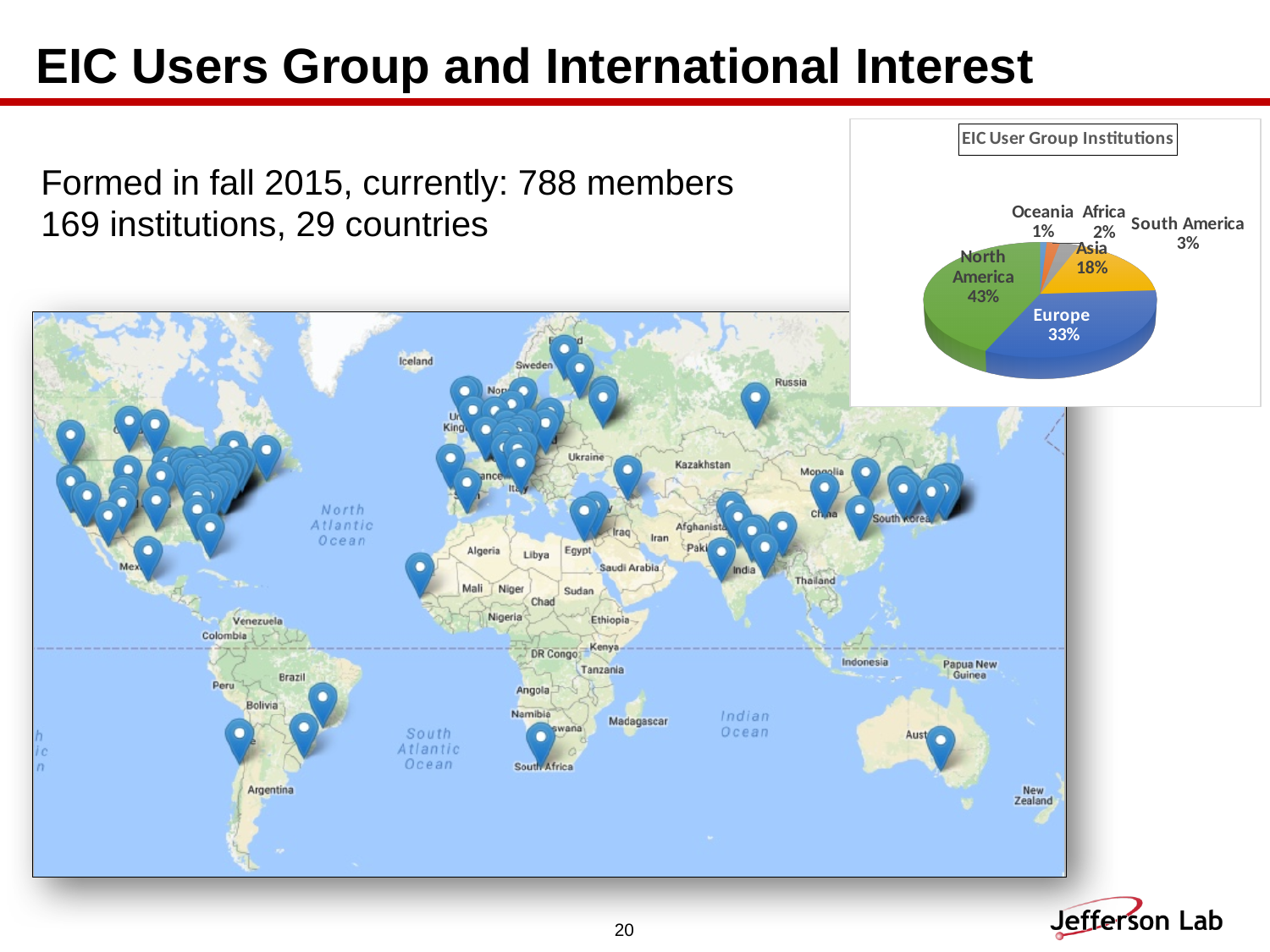
What share of EIC User Group institutions is from Europe? 33% What share of EIC User Group institutions is from Africa? 2% What share of EIC User Group institutions is from South America? 3% What is the difference in percentage points between North America's and Europe's shares in the pie chart? 10 What share of EIC User Group institutions is from Asia? 18% Which region has the largest share in the EIC User Group Institutions pie chart? North America What type of chart is shown in the top right of the slide? Pie chart How many regions are shown in the EIC User Group Institutions pie chart? 6 Which has a larger share in the pie chart, Europe or Asia? Europe What is the title of the pie chart? EIC User Group Institutions What share of EIC User Group institutions is from North America? 43% Which region has the smallest share in the EIC User Group Institutions pie chart? Oceania